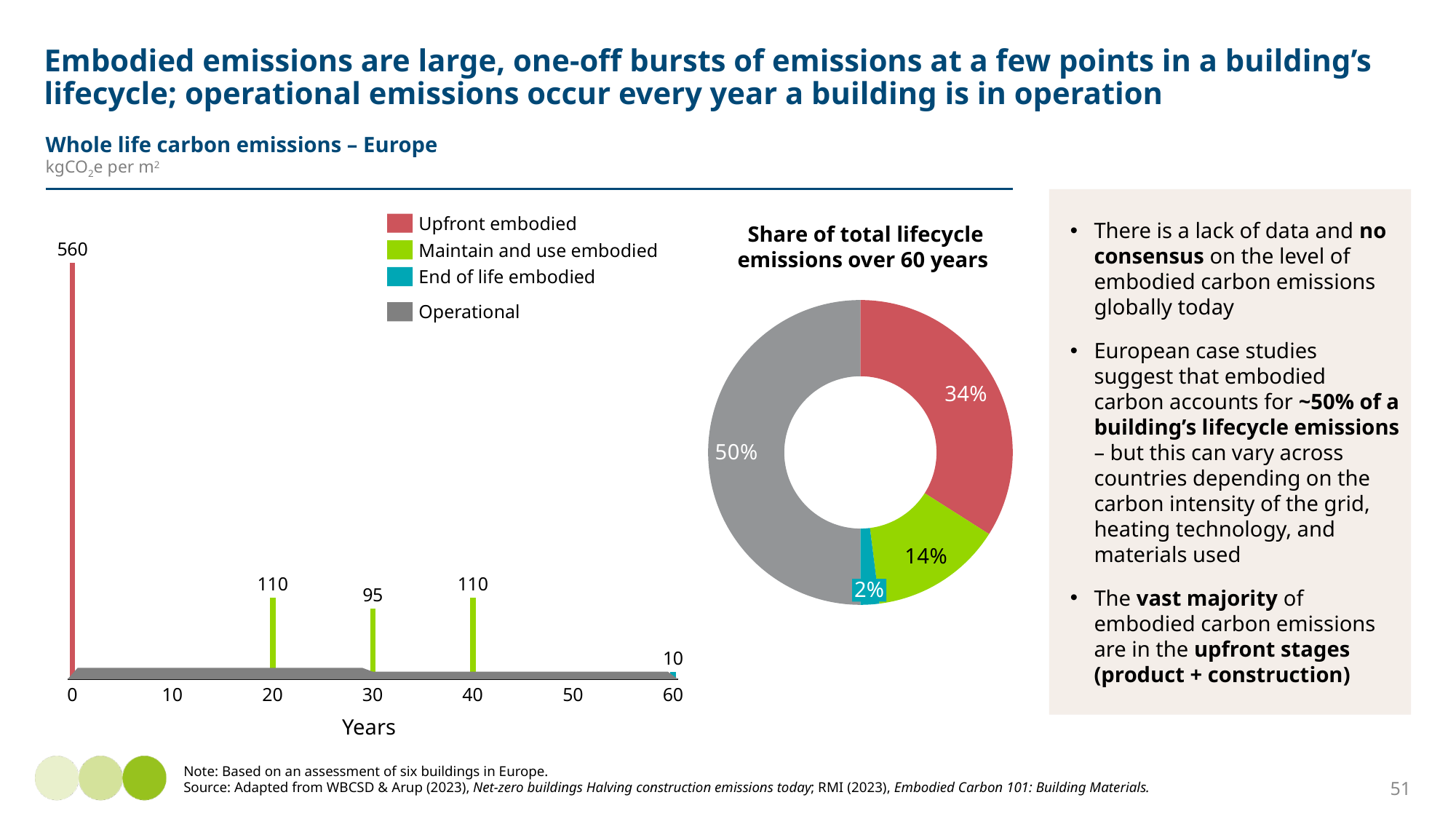
In the bar chart on the left, what is the value of the end of life embodied emissions at year 60? 10 In the bar chart on the left, what is the difference between the upfront embodied value at year 0 and the maintain and use embodied value at year 20? 450 In the bar chart on the left, which year has the highest embodied emissions value? 0 In the 'Share of total lifecycle emissions over 60 years' chart, what share is operational emissions? 50% In the bar chart on the left, what is the value of the maintain and use embodied emissions at year 30? 95 What unit is shown under the title 'Whole life carbon emissions – Europe'? kgCO2e per m2 In the 'Share of total lifecycle emissions over 60 years' chart, what share is upfront embodied emissions? 34% How many series does the legend of the bar chart on the left list? 4 What kind of chart is the 'Share of total lifecycle emissions over 60 years' chart? Pie chart (donut) In the bar chart on the left, which is larger: the embodied value at year 20 or at year 30? Year 20 In the 'Share of total lifecycle emissions over 60 years' chart, which category has the smallest share? End of life embodied In the bar chart on the left, what is the value of the upfront embodied emissions at year 0? 560